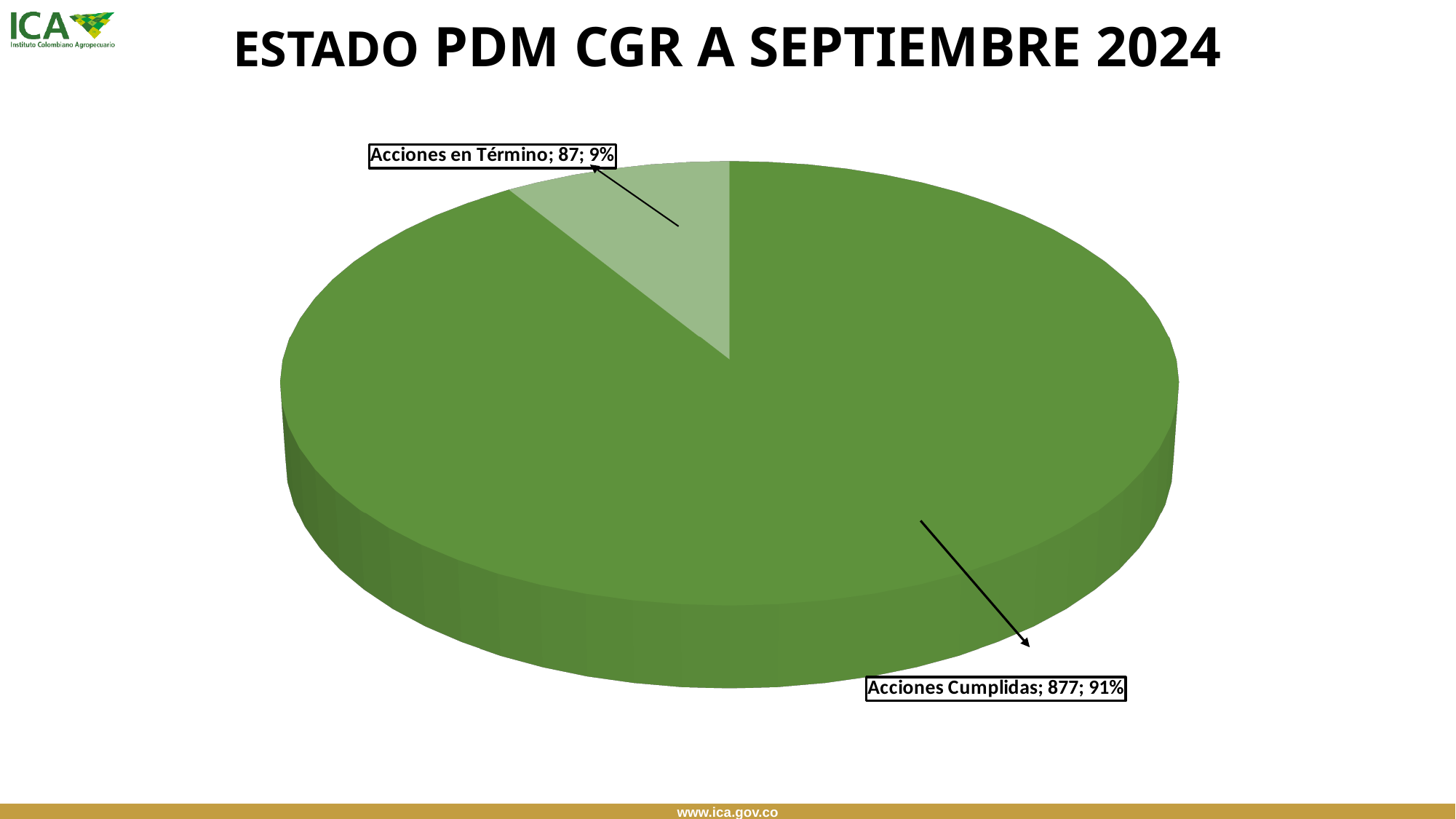
Which is larger, Acciones Cumplidas or Acciones en Término? Acciones Cumplidas What is the title of the slide containing the pie chart? ESTADO PDM CGR A SEPTIEMBRE 2024 What is the total of the two slices in the pie chart? 964 What is the difference between the values for Acciones Cumplidas and Acciones en Término? 790 What is the value for Acciones en Término? 87 Which category has the smallest slice? Acciones en Término Which category has the largest slice? Acciones Cumplidas What is the value for Acciones Cumplidas? 877 What kind of chart is shown on the slide? Pie chart What share of the pie does Acciones Cumplidas represent? 91% How many slices does the pie chart have? 2 What share of the pie does Acciones en Término represent? 9%